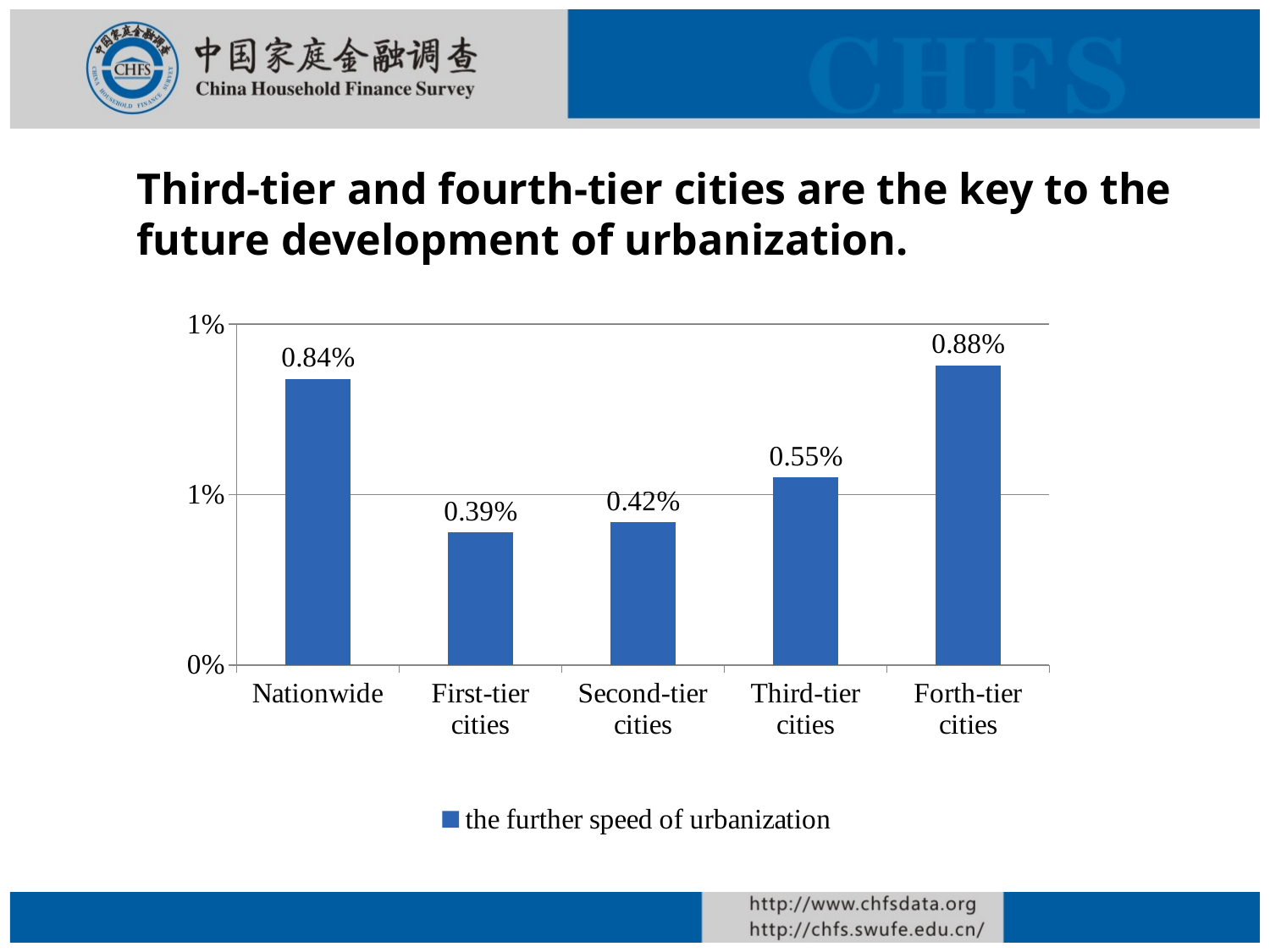
Which category has the highest value? Forth-tier cities What is the value for Third-tier cities? 0.55% What is the value for Nationwide? 0.84% What is the value for Second-tier cities? 0.42% Which category has the lowest value? First-tier cities What is the difference between the values for Third-tier cities and First-tier cities? 0.16% Which is larger, the value for Second-tier cities or the value for Third-tier cities? Third-tier cities How many series does the legend list? 1 What is the difference between the values for Forth-tier cities and Nationwide? 0.04% How many categories are shown on the x axis? 5 What is the legend entry for the series shown? the further speed of urbanization What kind of chart is shown on the slide? Bar chart